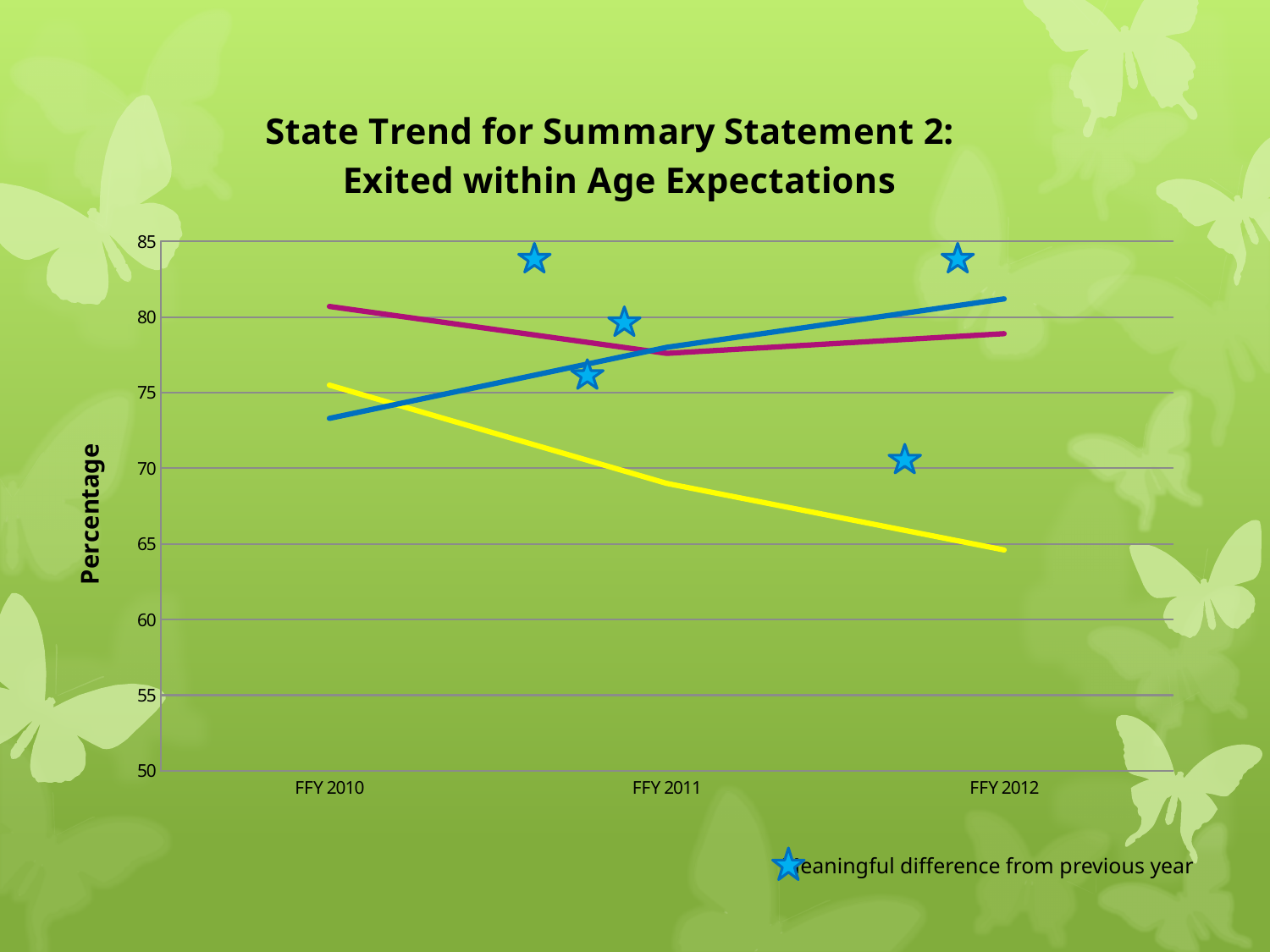
Which line has the highest value at FFY 2010? the magenta line Is the value of the blue line at FFY 2010 greater or less than 75? less At FFY 2012, which is higher, the blue line or the yellow line? the blue line Is the value of the blue line at FFY 2012 greater or less than 80? greater Is the value of the yellow line at FFY 2012 greater or less than 70? less Does the yellow line rise or fall from FFY 2010 to FFY 2012? fall Does the blue line rise or fall from FFY 2010 to FFY 2012? rise What is the title of the chart? State Trend for Summary Statement 2: Exited within Age Expectations What kind of chart is shown on the slide? line chart How many points are plotted along the x axis of the chart? 3 What is the label on the vertical axis of the chart? Percentage Which line has the lowest value at FFY 2012? the yellow line